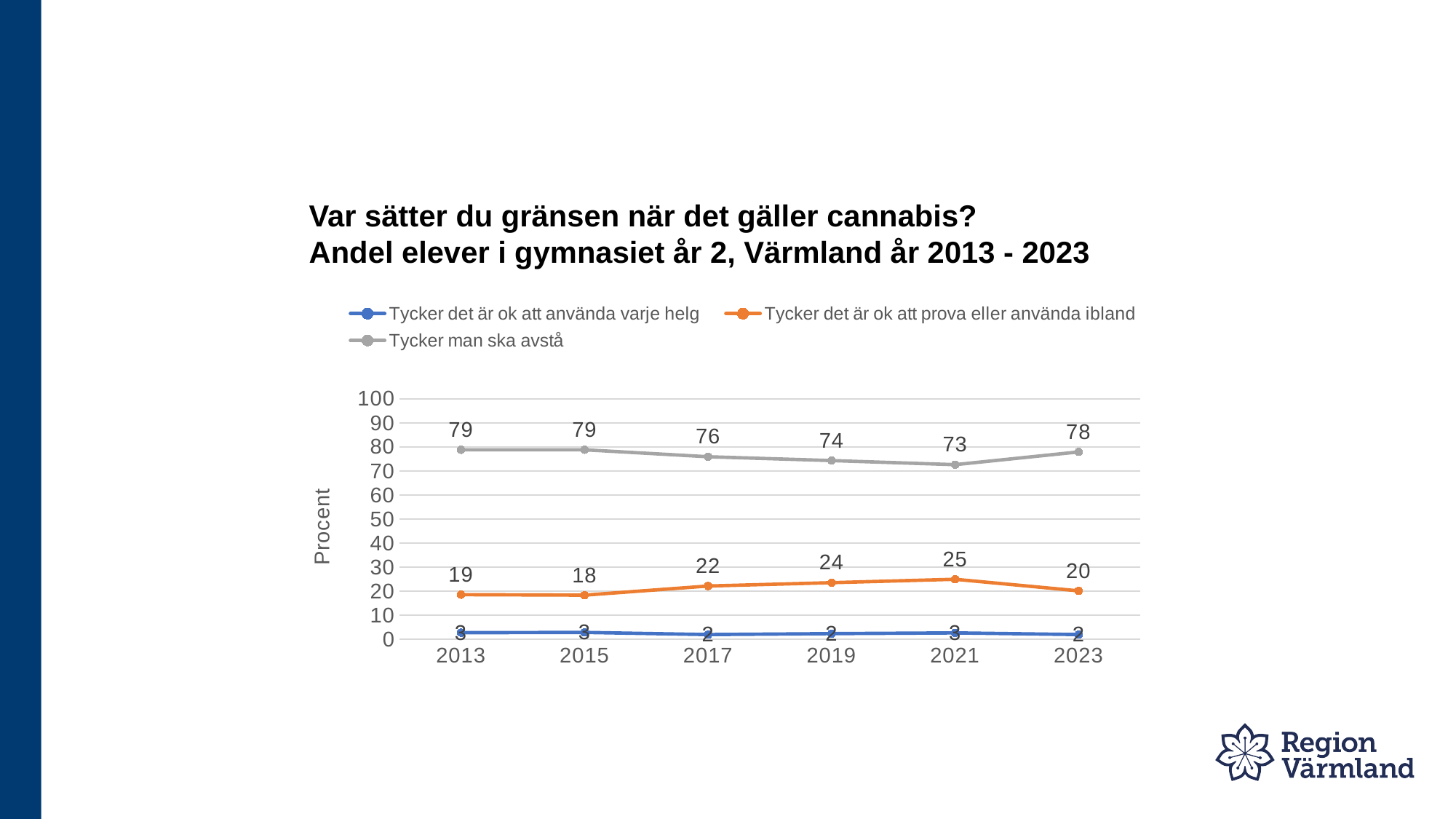
What is the label on the y axis? Procent In which year is 'Tycker det är ok att prova eller använda ibland' highest? 2021 Does 'Tycker det är ok att prova eller använda ibland' rise or fall from 2013 to 2021? rise How many series does the legend list? 3 What kind of chart is shown on the slide? line chart What is the value for 'Tycker man ska avstå' in 2023? 78 In which year is 'Tycker man ska avstå' lowest? 2021 How many years are plotted along the x axis? 6 What is the value for 'Tycker man ska avstå' in 2021? 73 Which is larger in 2023: 'Tycker man ska avstå' or 'Tycker det är ok att prova eller använda ibland'? Tycker man ska avstå What is the value for 'Tycker det är ok att prova eller använda ibland' in 2019? 24 What is the difference between the 'Tycker man ska avstå' values in 2013 and 2021? 6